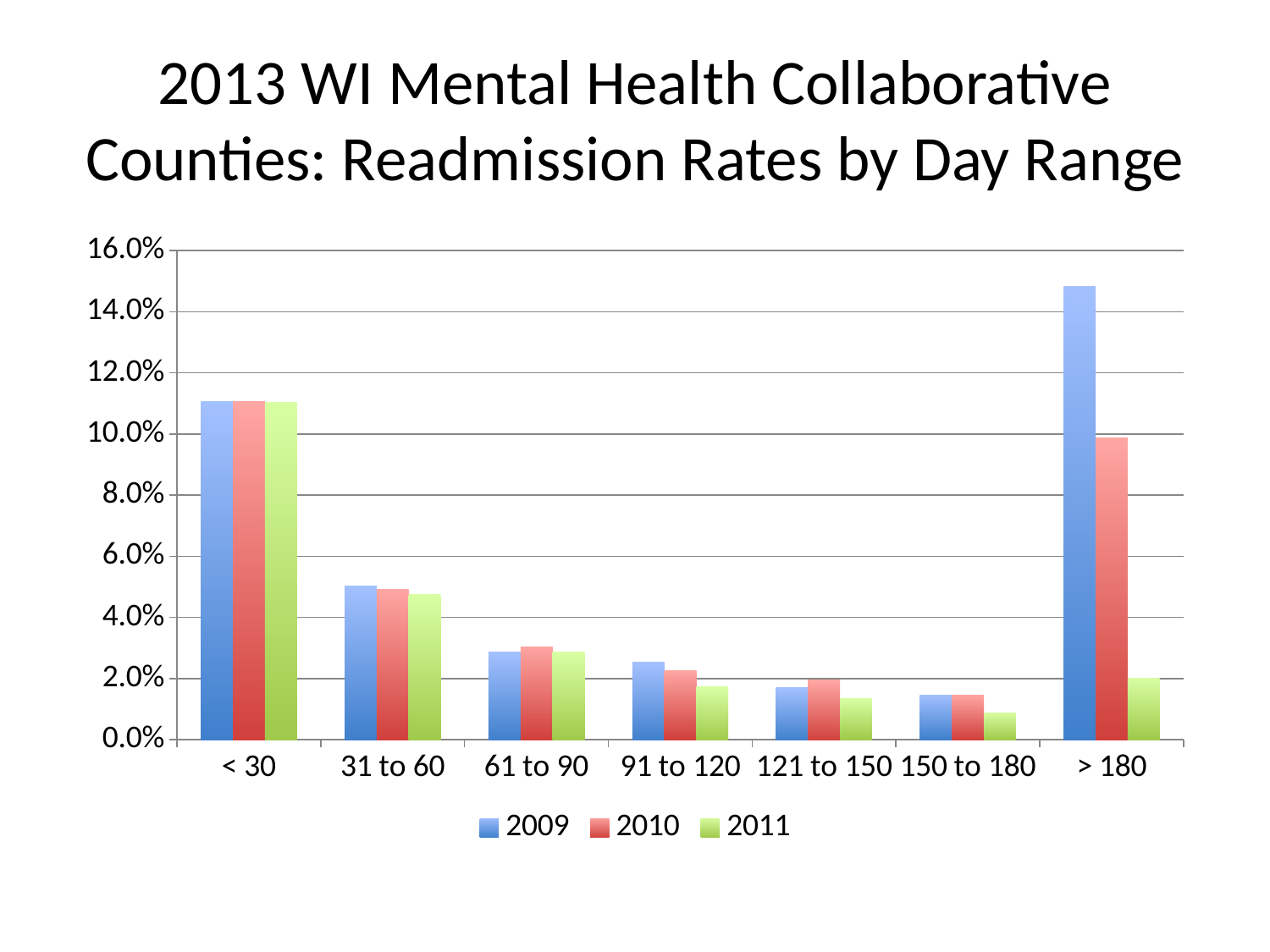
Which day range has the highest readmission rate for 2009? > 180 Which day range has the lowest readmission rate for 2011? 150 to 180 Is the 2011 value for < 30 greater or less than 10.0%? greater For the > 180 day range, which is larger: the 2009 value or the 2011 value? 2009 Is the 2009 value for > 180 greater or less than 14.0%? greater Is the 2010 value for > 180 greater or less than 10.0%? less How many day-range categories are shown on the x axis? 7 What kind of chart is shown on the slide? bar chart How many series does the legend list? 3 What are the three entries in the legend? 2009, 2010, 2011 For the 2011 series, do the values rise or fall from < 30 through 150 to 180? fall For the 91 to 120 day range, which is larger: the 2010 value or the 2011 value? 2010